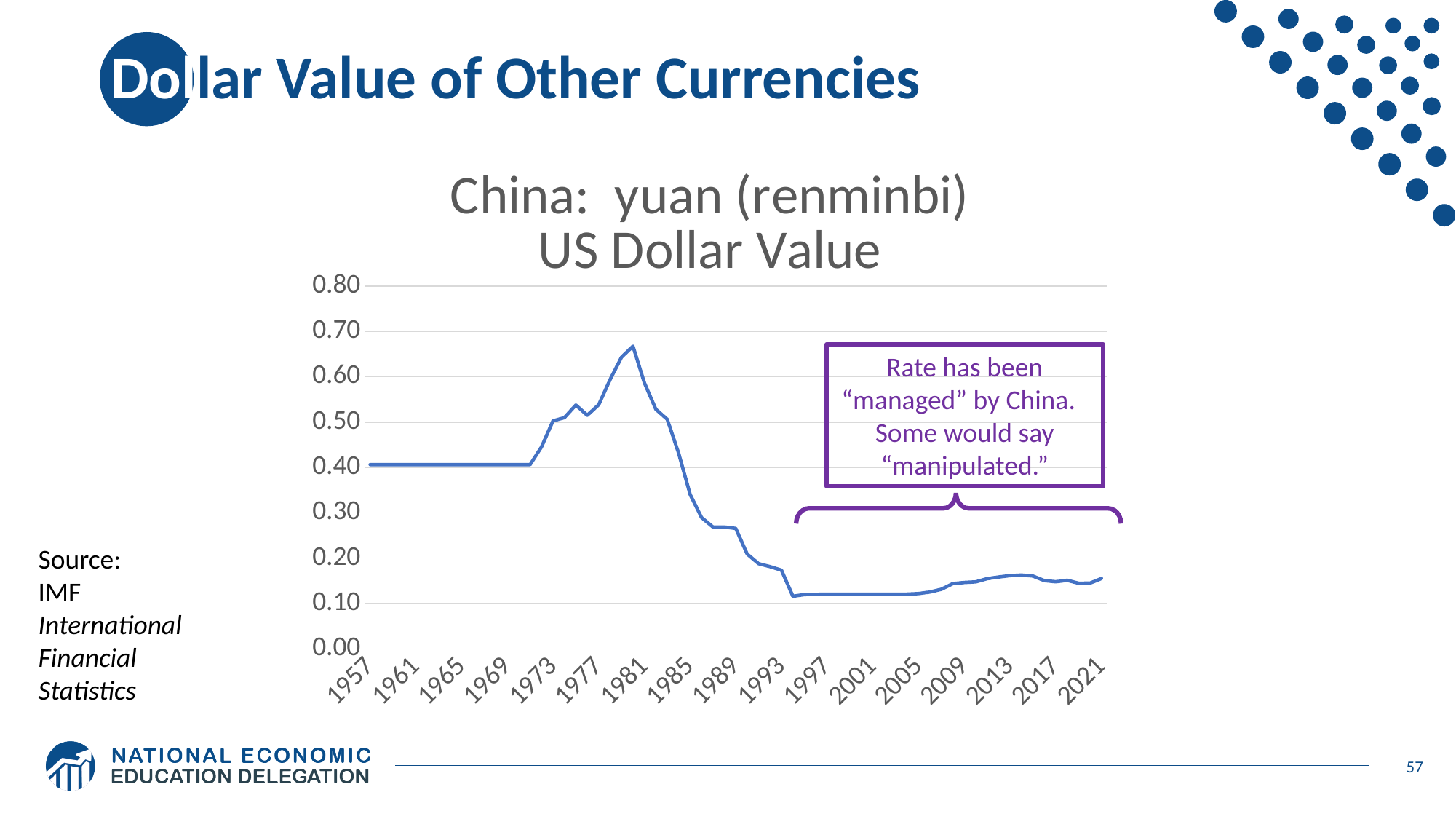
Does the value rise or fall between 1981 and 1993? Fall How many year labels are shown on the x axis? 17 Is the value for 1989 greater or less than 0.30? less Is the value for 2021 greater or less than 0.20? less What is the title of the chart? China: yuan (renminbi) US Dollar Value What is the highest value labelled on the y axis? 0.80 Is the value in 1981 higher or lower than the value in 2021? Higher Is the value for 1977 greater or less than 0.50? greater What kind of chart is shown on the slide? Line chart In which decade does the line reach its highest value? 1980s